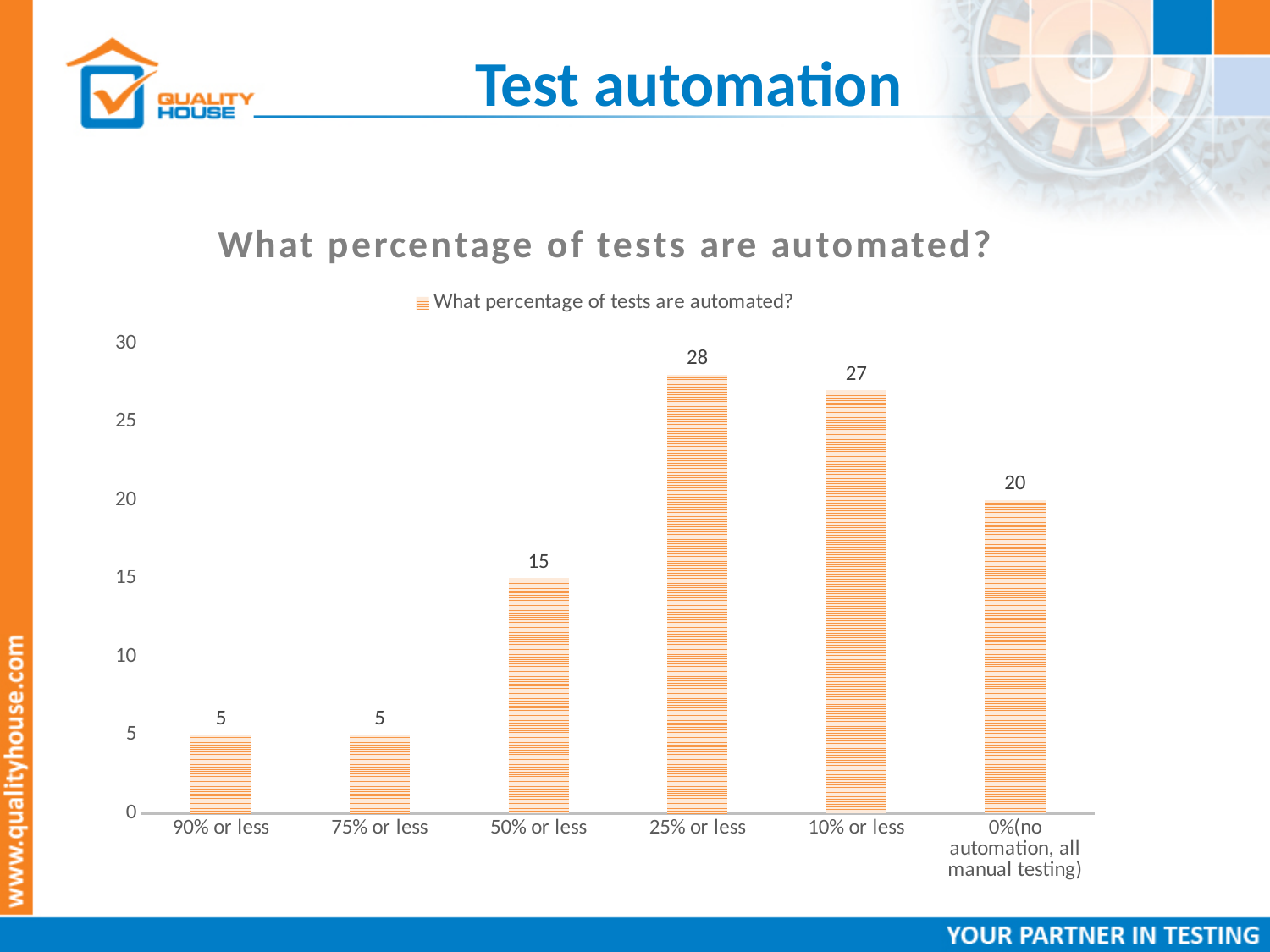
What is the value for "25% or less"? 28 Is the value for "10% or less" greater or less than 25? greater What is the title of the chart? What percentage of tests are automated? Which is larger, the value for "50% or less" or the value for "0%(no automation, all manual testing)"? 0%(no automation, all manual testing) What is the value for "50% or less"? 15 What is the value for "0%(no automation, all manual testing)"? 20 How many categories are shown on the x axis? 6 What kind of chart is shown on the slide? Bar chart What is the difference between the values for "25% or less" and "10% or less"? 1 Which category has the highest value? 25% or less What is the difference between the values for "10% or less" and "0%(no automation, all manual testing)"? 7 How many series does the legend list? 1